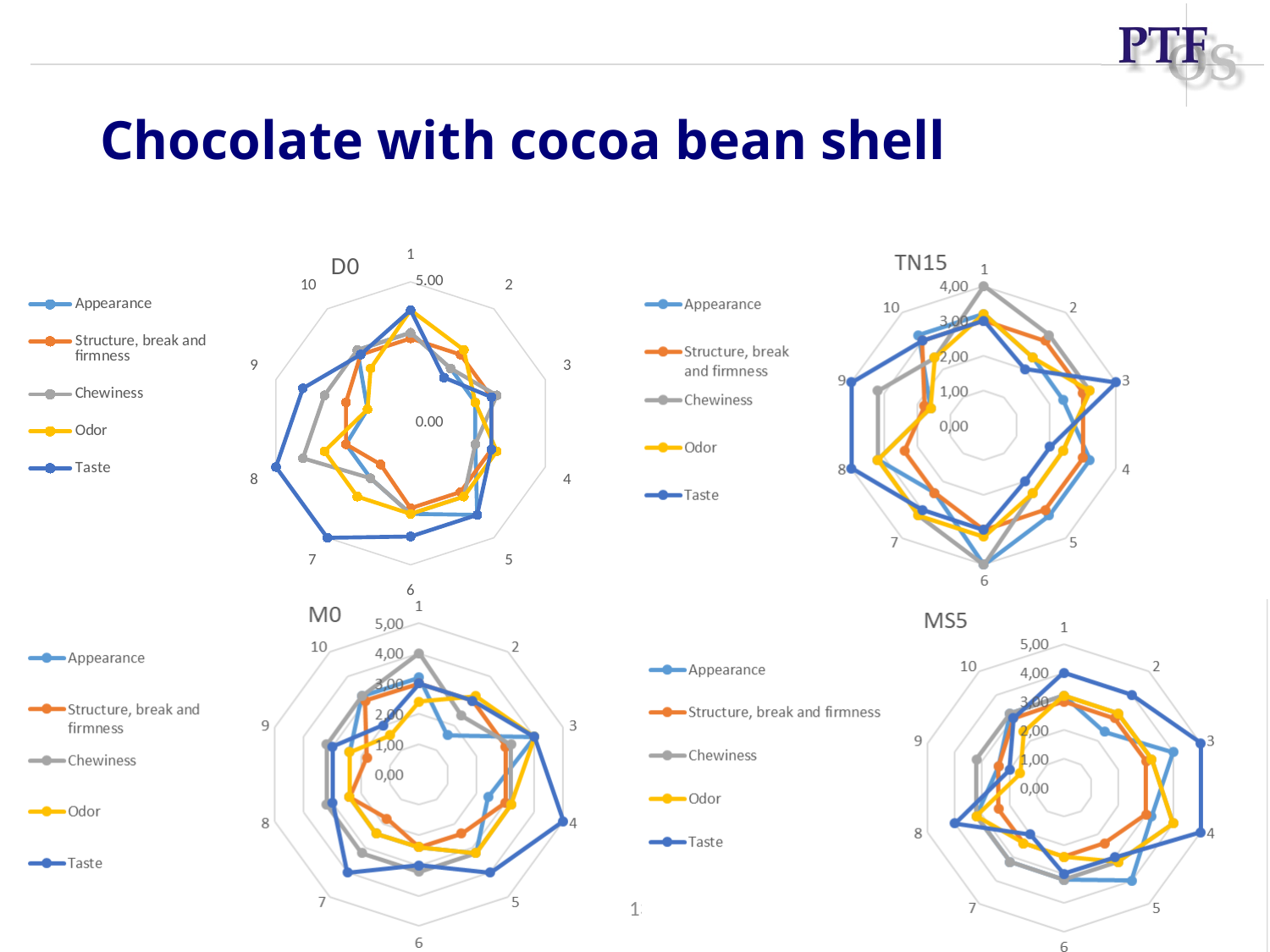
In the M0 chart, is the Appearance value for category 2 greater or less than 3,00? less In the TN15 chart, is the Chewiness value for category 6 greater or less than 3,00? greater In the TN15 chart, is the Taste value for category 2 greater or less than 3,00? less How many categories (axes) does the M0 radar chart have? 10 What kind of chart is the D0 chart? Radar chart How many series does the legend of the TN15 chart list? 5 What is the title of the top-left radar chart? D0 How many categories (axes) does the MS5 radar chart have? 10